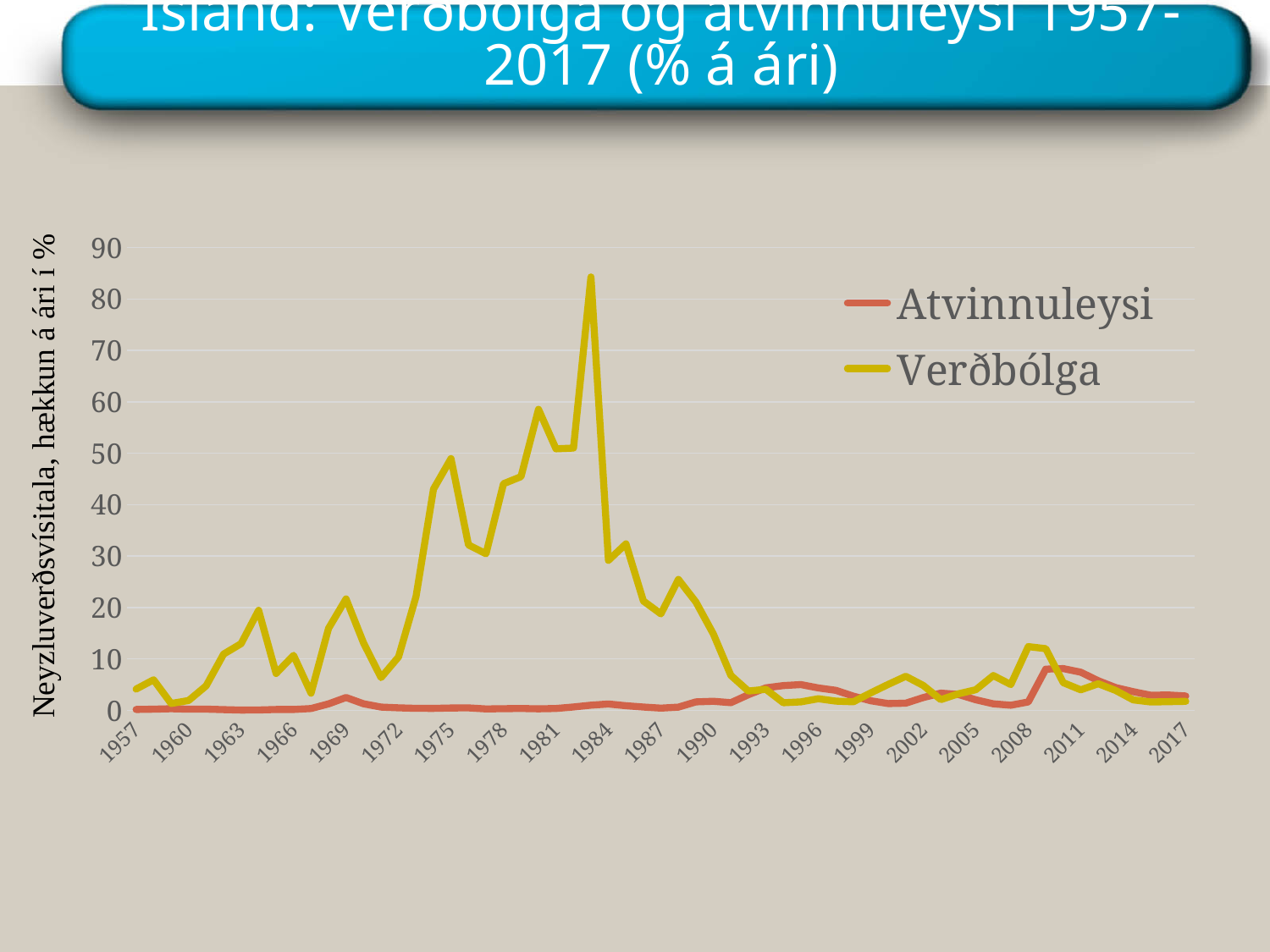
In 1984, which series has the larger value, Atvinnuleysi or Verðbólga? Verðbólga Is the value for Verðbólga in 1957 greater or less than 10? less What kind of chart is shown on the slide? line chart What is the label on the vertical axis? Neyzluverðsvísitala, hækkun á ári í % Does the Verðbólga line rise or fall between 1984 and 1993? fall Which series reaches the highest value on the chart? Verðbólga Is the value for Verðbólga in 1975 greater or less than 40? greater How many series does the legend list? 2 Is the value for Atvinnuleysi in 1984 greater or less than 10? less Which colour is used for the Atvinnuleysi series? red